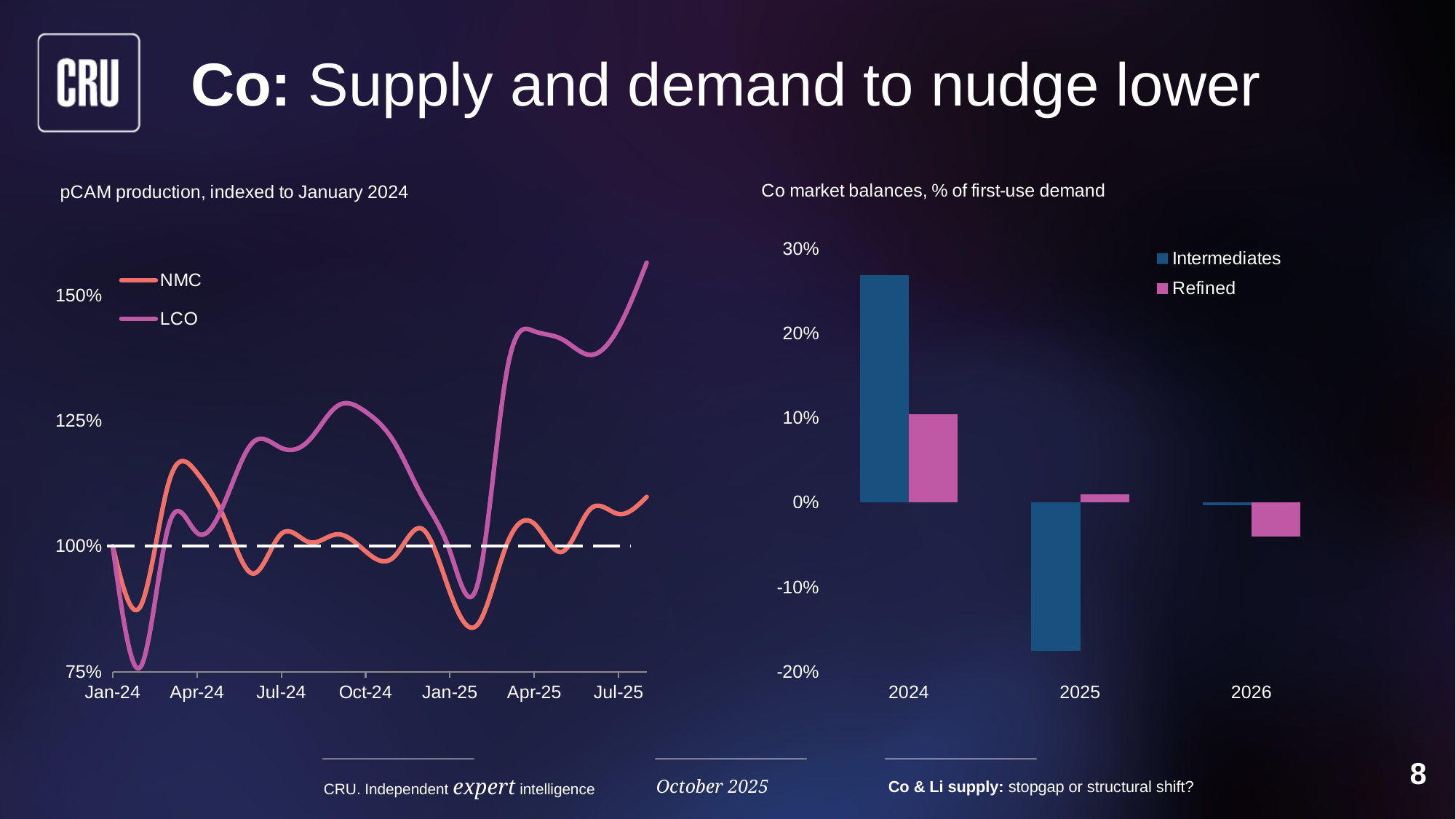
How many years are shown on the x axis of the 'Co market balances' chart? 3 In the 'Co market balances' chart, is the Intermediates value for 2024 greater or less than 20%? greater In the 'pCAM production' chart, which series is higher at Jul-25, NMC or LCO? LCO In the 'Co market balances' chart, which year has the highest Intermediates value? 2024 In the 'Co market balances' chart, is the Refined value for 2026 greater or less than 0%? less What kind of chart is the 'pCAM production, indexed to January 2024' chart? Line chart How many series does the legend of the 'pCAM production' chart list? 2 In the 'Co market balances' chart, which is larger in 2024, Intermediates or Refined? Intermediates In the 'Co market balances' chart, which year has the lowest Intermediates value? 2025 What kind of chart is the 'Co market balances, % of first-use demand' chart? Bar chart In the 'Co market balances' chart, is the Intermediates value for 2025 greater or less than -10%? less